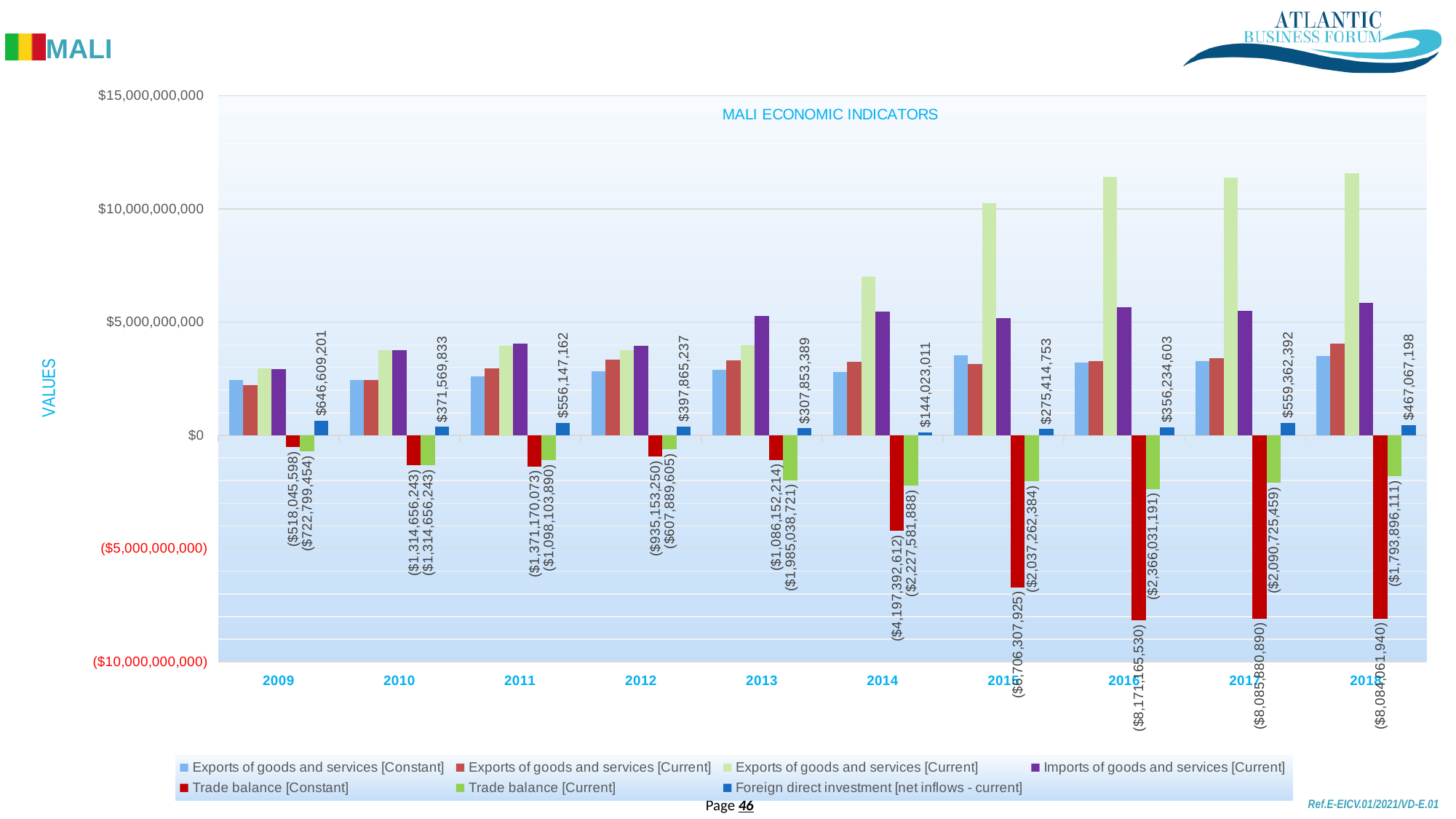
How many years are shown on the x axis? 10 What type of chart is shown on the slide? Bar chart Which is larger, Foreign direct investment in 2009 or in 2018? 2009 Is the value of Exports of goods and services [Current] (light green) in 2016 greater or less than $10,000,000,000? greater How many series does the legend list? 7 What is the value of Trade balance [Constant] in 2016? ($8,171,165,530) In which year is Foreign direct investment [net inflows - current] highest? 2009 What is the difference between Foreign direct investment in 2009 and in 2010? $275,039,368 What is the title of the chart? MALI ECONOMIC INDICATORS What is the value of Foreign direct investment [net inflows - current] in 2009? $646,609,201 In which year is Foreign direct investment [net inflows - current] lowest? 2014 What is the value of Trade balance [Current] in 2013? ($1,985,038,721)